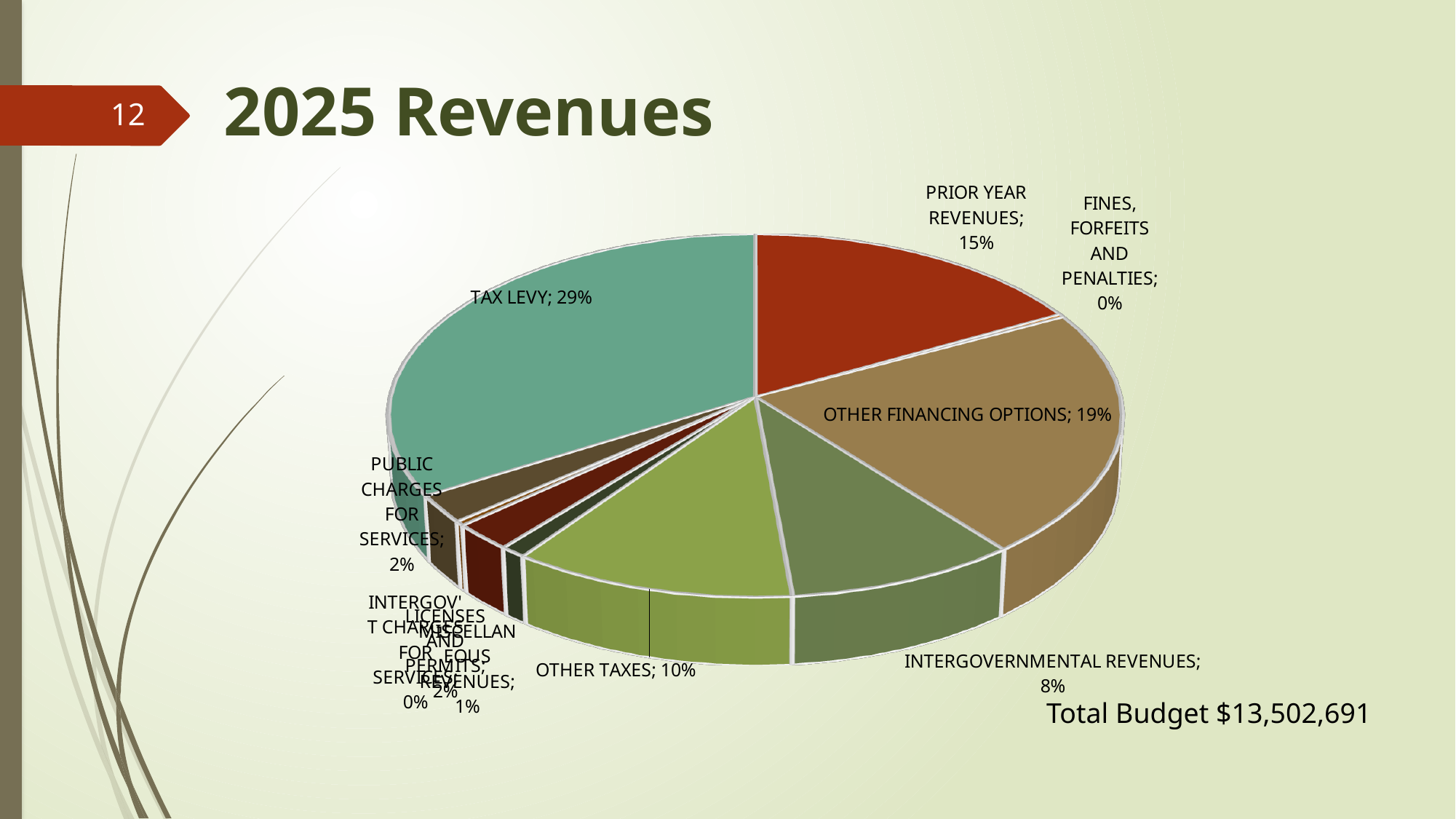
What kind of chart is shown on the slide? pie chart What share of revenues comes from Other Taxes? 10% What percentage is shown for Intergovernmental Revenues? 8% Which is larger, the share for Prior Year Revenues or the share for Other Taxes? Prior Year Revenues What share of revenues comes from Prior Year Revenues? 15% What percentage of revenues is labelled as Other Financing Options? 19% What is the difference in percentage points between Tax Levy and Other Financing Options? 10 What is the title of the slide containing the chart? 2025 Revenues What percentage is shown for Fines, Forfeits and Penalties? 0% What is the total budget stated on the slide? $13,502,691 What share of 2025 revenues comes from the tax levy? 29% Which revenue category has the largest share of the pie? Tax Levy